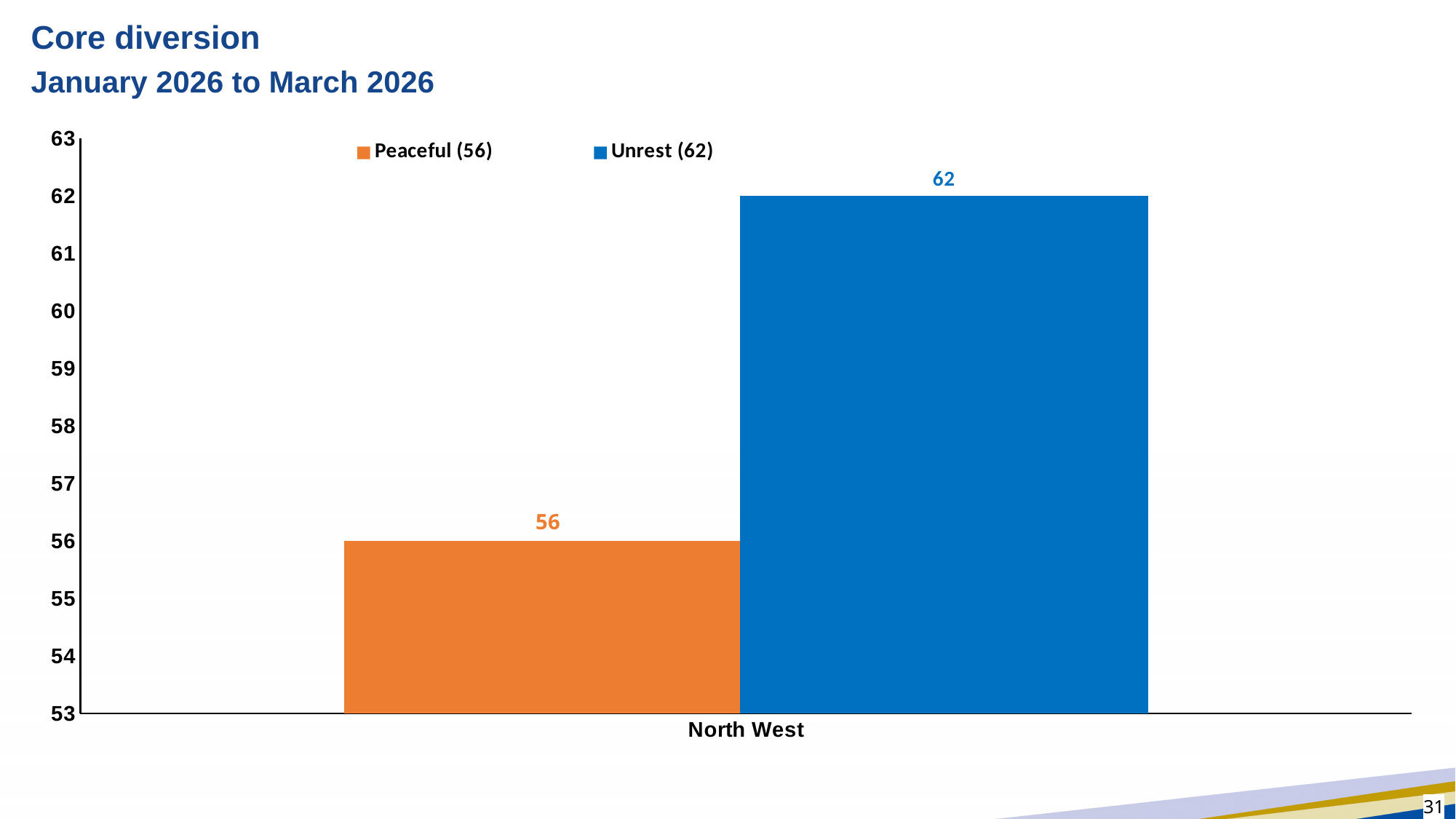
Which series has the highest value on the chart? Unrest Is the value for Peaceful greater or less than 58? less What colour is the bar for the Unrest series? Blue What is the value for Peaceful in the North West? 56 Which series has the lowest value on the chart? Peaceful How many categories are shown on the x axis? 1 How many series does the legend list? 2 Which series has the higher value for North West, Peaceful or Unrest? Unrest What kind of chart is shown on the slide? Bar chart What is the difference between the Unrest and Peaceful values for North West? 6 What is the value for Unrest in the North West? 62 Is the value for Unrest greater or less than 60? greater